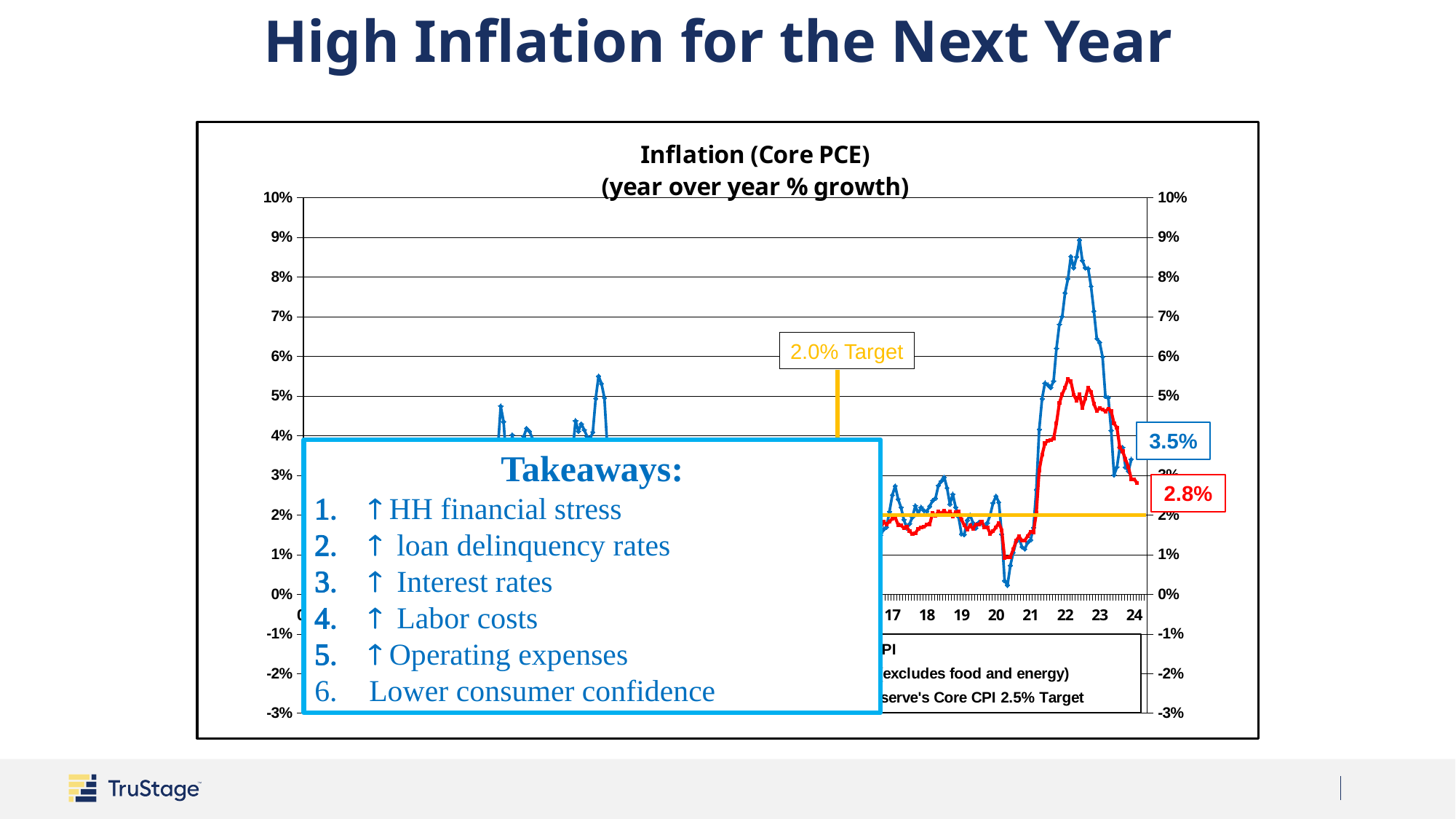
Do the plotted lines rise or fall from their 2022 peaks to 2024? fall Is the peak of the red line around 2022 greater or less than 5%? greater What is the title of the chart? Inflation (Core PCE) (year over year % growth) What is the difference between the labeled latest values of the blue line (3.5%) and the red line (2.8%)? 0.7% What target value is labeled on the chart? 2.0% Target Which line has the higher labeled latest value, the blue line or the red line? blue line What is the highest value shown on the y axis? 10% What is the latest value labeled on the red line? 2.8% What kind of chart is shown on the slide? line chart Is the lowest point of the blue line around 2020 greater or less than 1%? less What is the latest value labeled on the blue line? 3.5% Is the peak of the blue line around 2022 greater or less than 8%? greater